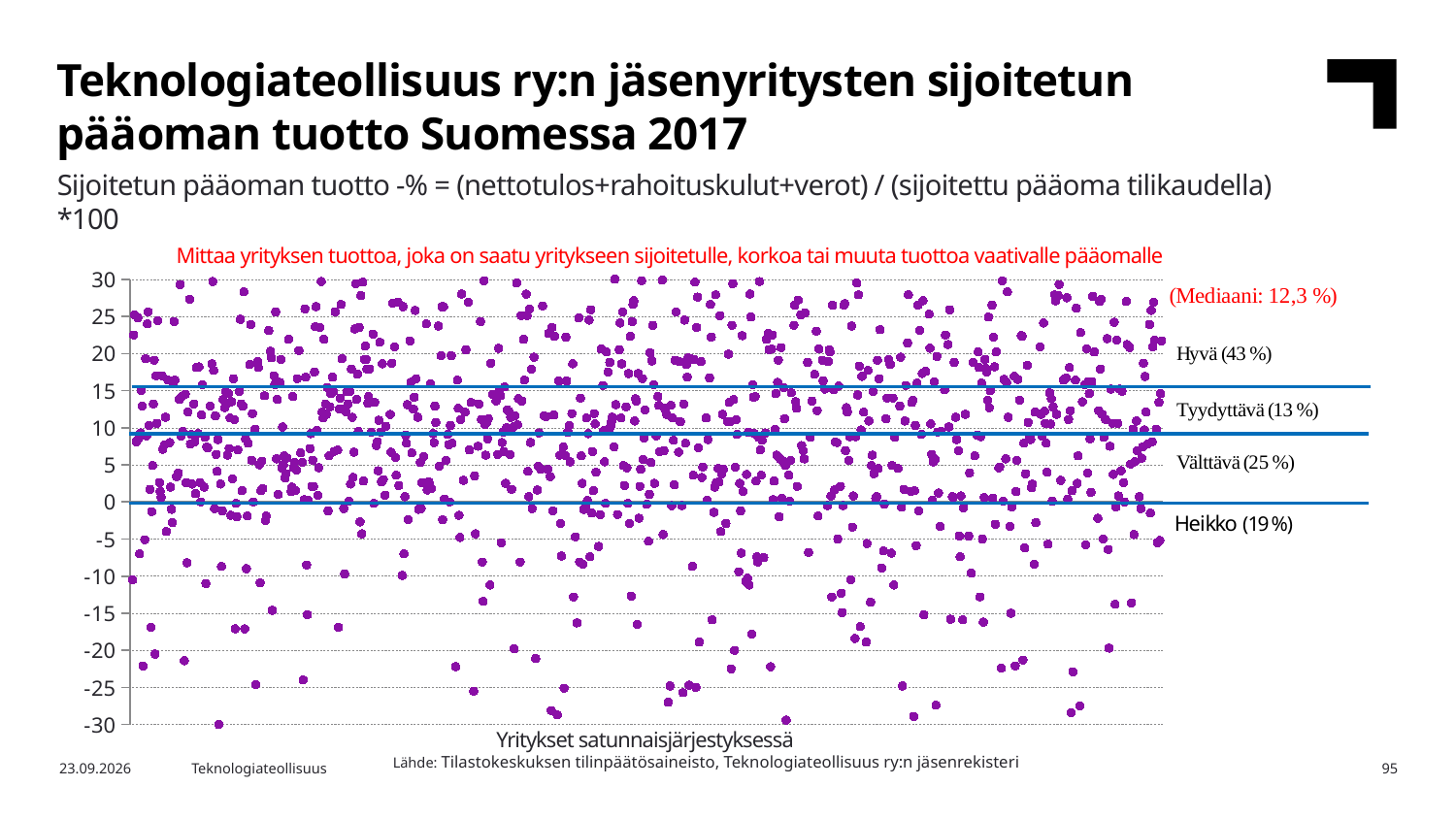
Is the median value shown on the chart greater or less than 10? greater Which category has a larger share of companies, 'Välttävä' or 'Tyydyttävä'? Välttävä What percentage of companies fall into the 'Välttävä' category? 25 % What kind of chart is shown on the slide? scatter chart Which category has the smallest share of companies? Tyydyttävä What is the median (Mediaani) value of return on invested capital shown on the chart? 12,3 % What percentage of companies fall into the 'Heikko' category? 19 % What percentage of companies fall into the 'Hyvä' category? 43 % Which category has the largest share of companies? Hyvä What is the x-axis label of the chart? Yritykset satunnaisjärjestyksessä What is the difference in percentage points between the 'Hyvä' share and the 'Heikko' share? 24 What percentage of companies fall into the 'Tyydyttävä' category? 13 %